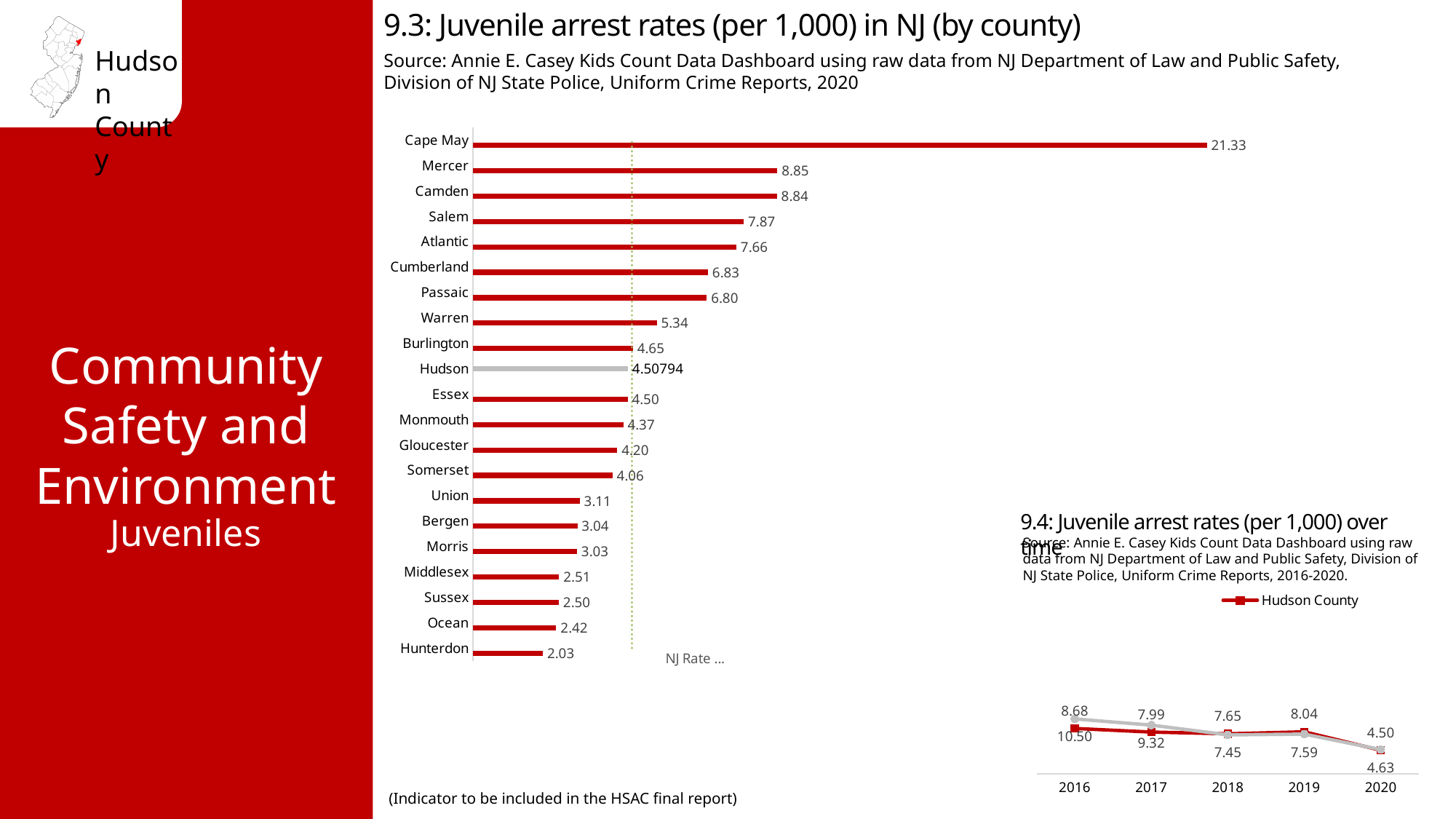
In the chart '9.4: Juvenile arrest rates (per 1,000) over time', do the values generally rise or fall from 2016 to 2020? Fall In the chart '9.4: Juvenile arrest rates (per 1,000) over time', how many years are shown on the x axis? 5 In the chart '9.3: Juvenile arrest rates (per 1,000) in NJ (by county)', what is the juvenile arrest rate for Passaic? 6.80 In the chart '9.3: Juvenile arrest rates (per 1,000) in NJ (by county)', what is the difference between the rates for Cape May and Mercer? 12.48 In the chart '9.3: Juvenile arrest rates (per 1,000) in NJ (by county)', which county has a higher rate, Salem or Atlantic? Salem In the chart '9.3: Juvenile arrest rates (per 1,000) in NJ (by county)', what is the value shown for Hudson? 4.50794 In the chart '9.3: Juvenile arrest rates (per 1,000) in NJ (by county)', how many counties are plotted? 21 In the chart '9.3: Juvenile arrest rates (per 1,000) in NJ (by county)', which county has the highest juvenile arrest rate? Cape May What kind of chart is '9.3: Juvenile arrest rates (per 1,000) in NJ (by county)'? Bar chart In the chart '9.3: Juvenile arrest rates (per 1,000) in NJ (by county)', which county has the lowest juvenile arrest rate? Hunterdon In the chart '9.3: Juvenile arrest rates (per 1,000) in NJ (by county)', what is the juvenile arrest rate for Cape May? 21.33 In the chart '9.4: Juvenile arrest rates (per 1,000) over time', what series name is shown in the legend? Hudson County